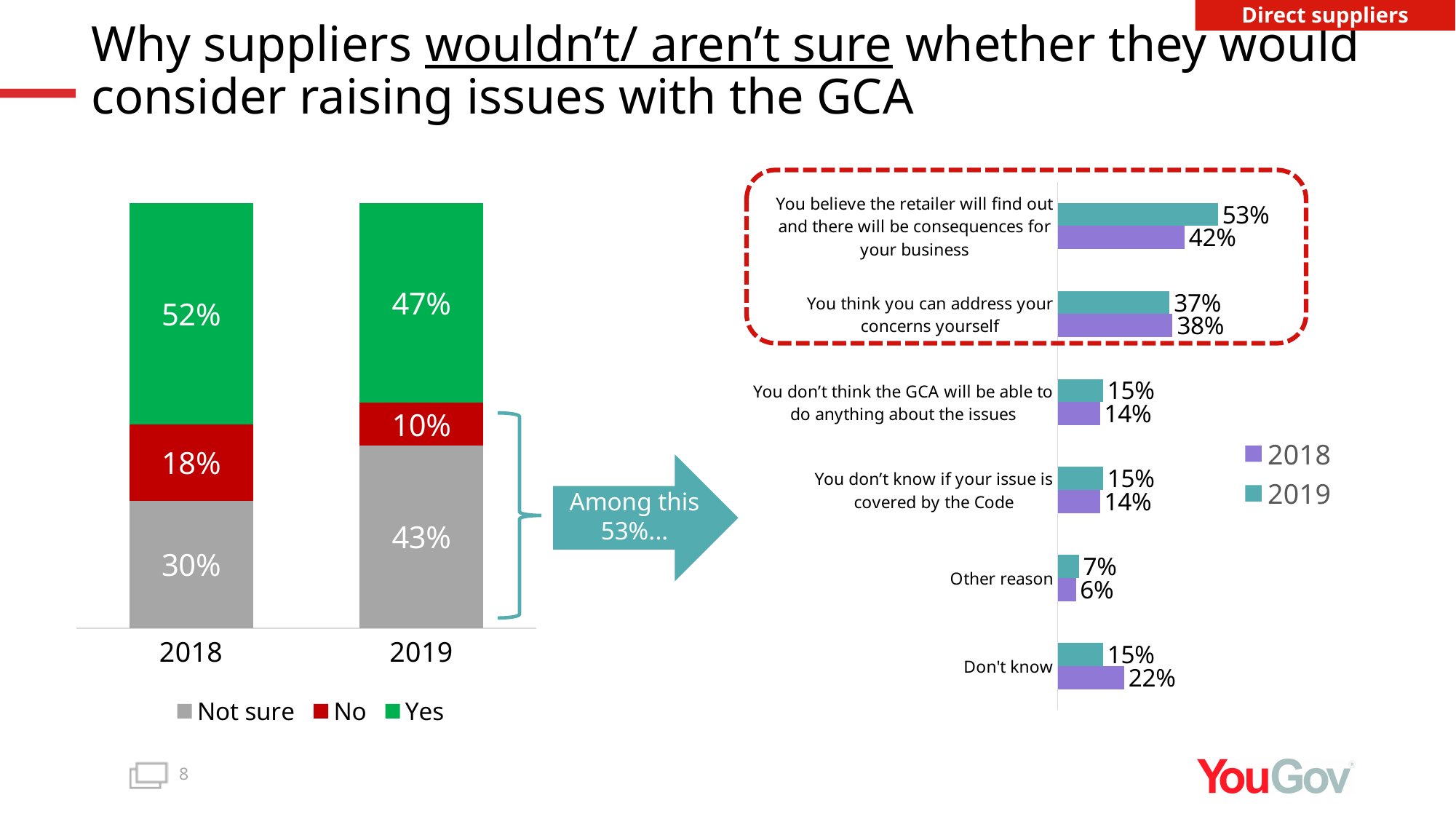
In the bar chart on the right, is the 2019 value for 'You think you can address your concerns yourself' larger or smaller than the 2018 value? Smaller In the bar chart on the right, which reason has the lowest value for 2018? Other reason What kind of chart is the chart on the left of the slide? Stacked bar chart In the bar chart on the right, how many reason categories are shown? 6 In the bar chart on the right, what percentage of suppliers in 2019 said they believe the retailer will find out and there will be consequences for their business? 53% In the stacked bar chart on the left, what is the difference between the 'No' share in 2018 and in 2019? 8 percentage points In the stacked bar chart on the left, what percentage of suppliers answered 'Yes' in 2019? 47% In the stacked bar chart on the left, how many series does the legend list? 3 In the stacked bar chart on the left, what percentage of suppliers answered 'Not sure' in 2018? 30% In the bar chart on the right, what percentage of suppliers in 2018 said 'Don't know'? 22% In the bar chart on the right, which reason has the highest value for 2019? You believe the retailer will find out and there will be consequences for your business In the stacked bar chart on the left, what is the combined share of 'Not sure' and 'No' in 2019? 53%